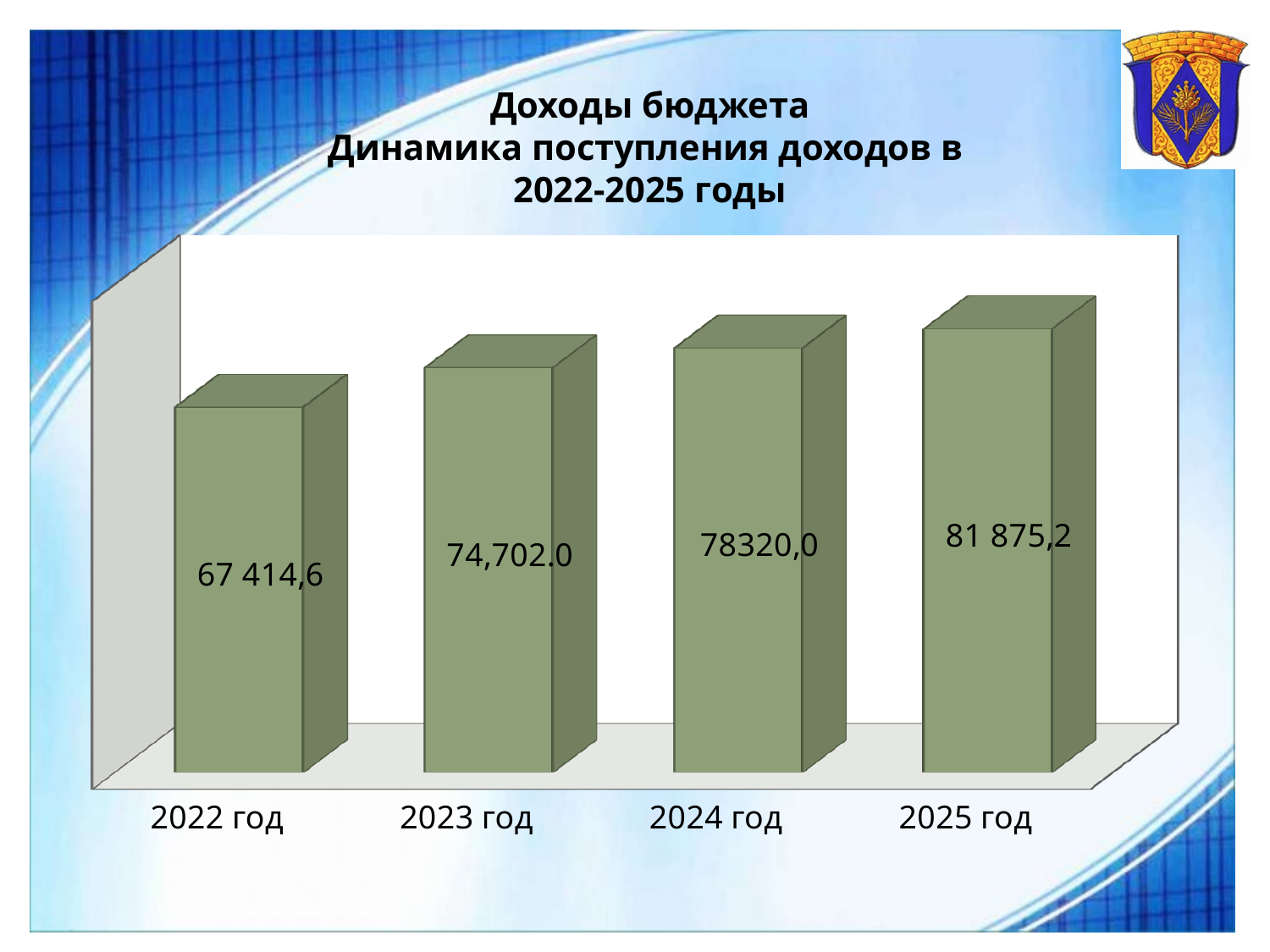
Which year has the lowest value? 2022 год What kind of chart is shown on the slide? Bar chart Which is larger, the value for 2023 год or the value for 2024 год? 2024 год What is the title of the chart on the slide? Доходы бюджета Динамика поступления доходов в 2022-2025 годы Do the values rise or fall from 2022 год to 2025 год? Rise What is the value shown for 2025 год? 81 875,2 How many years (bars) are shown in the chart? 4 Which year has the highest value? 2025 год What is the value shown for 2023 год? 74,702.0 What is the value shown for 2024 год? 78320,0 What is the value shown for 2022 год? 67 414,6 What colour are the bars in the chart? Green